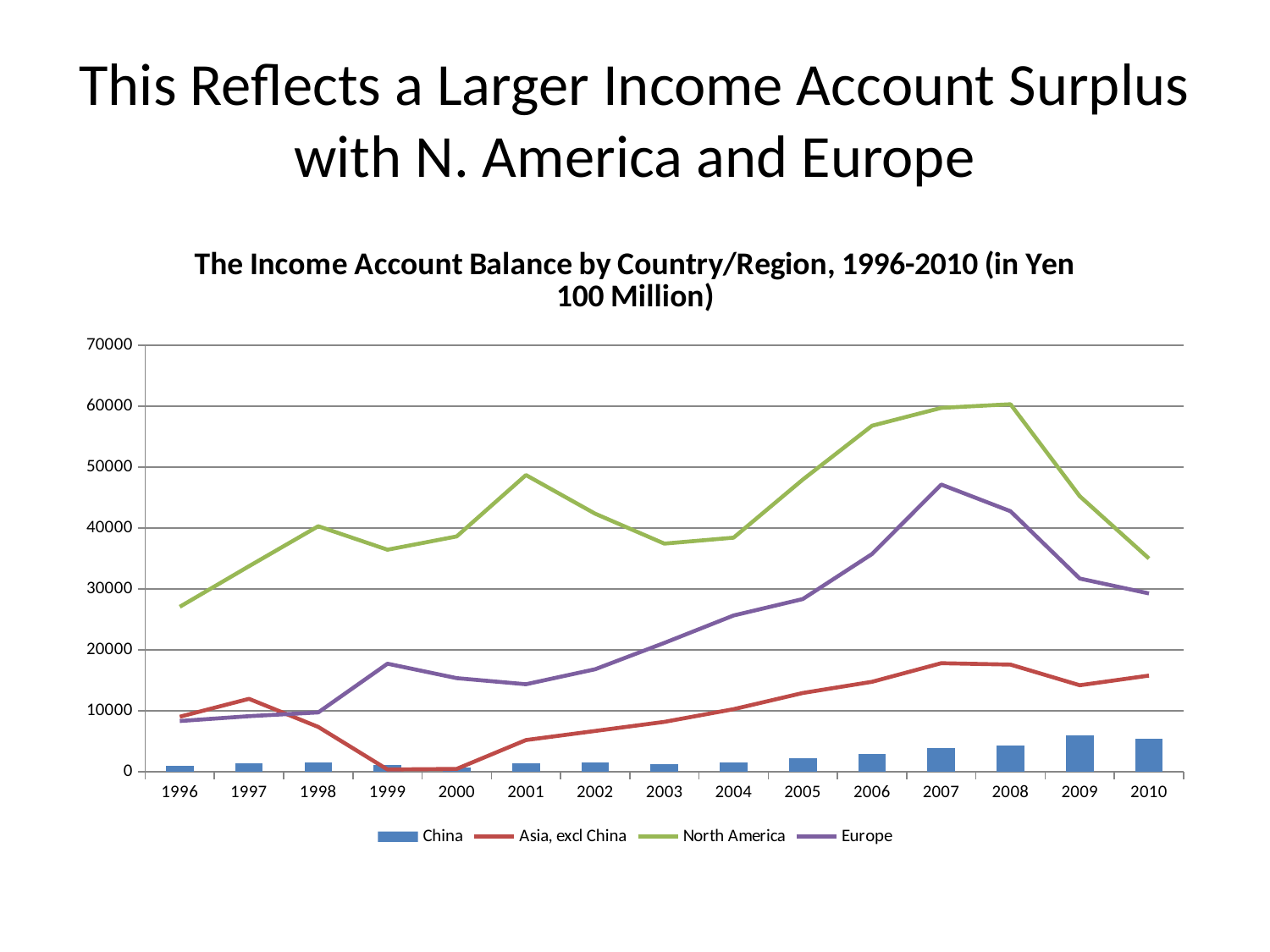
Is the value for North America in 2008 greater or less than 50000? greater What is the title of the chart? The Income Account Balance by Country/Region, 1996-2010 (in Yen 100 Million) How many years are shown on the x axis? 15 Which series is plotted as bars rather than a line? China In which year is the China bar the tallest? 2009 Does the North America line rise or fall from 2008 to 2010? fall Is the value for Europe in 2007 greater or less than 40000? greater Is the value for Asia, excl China in 1999 greater or less than 10000? less Which series has the highest value in 2010? North America How many series does the legend list? 4 Which is larger in 2010, Europe or Asia, excl China? Europe What kind of chart is this? Combination bar and line chart